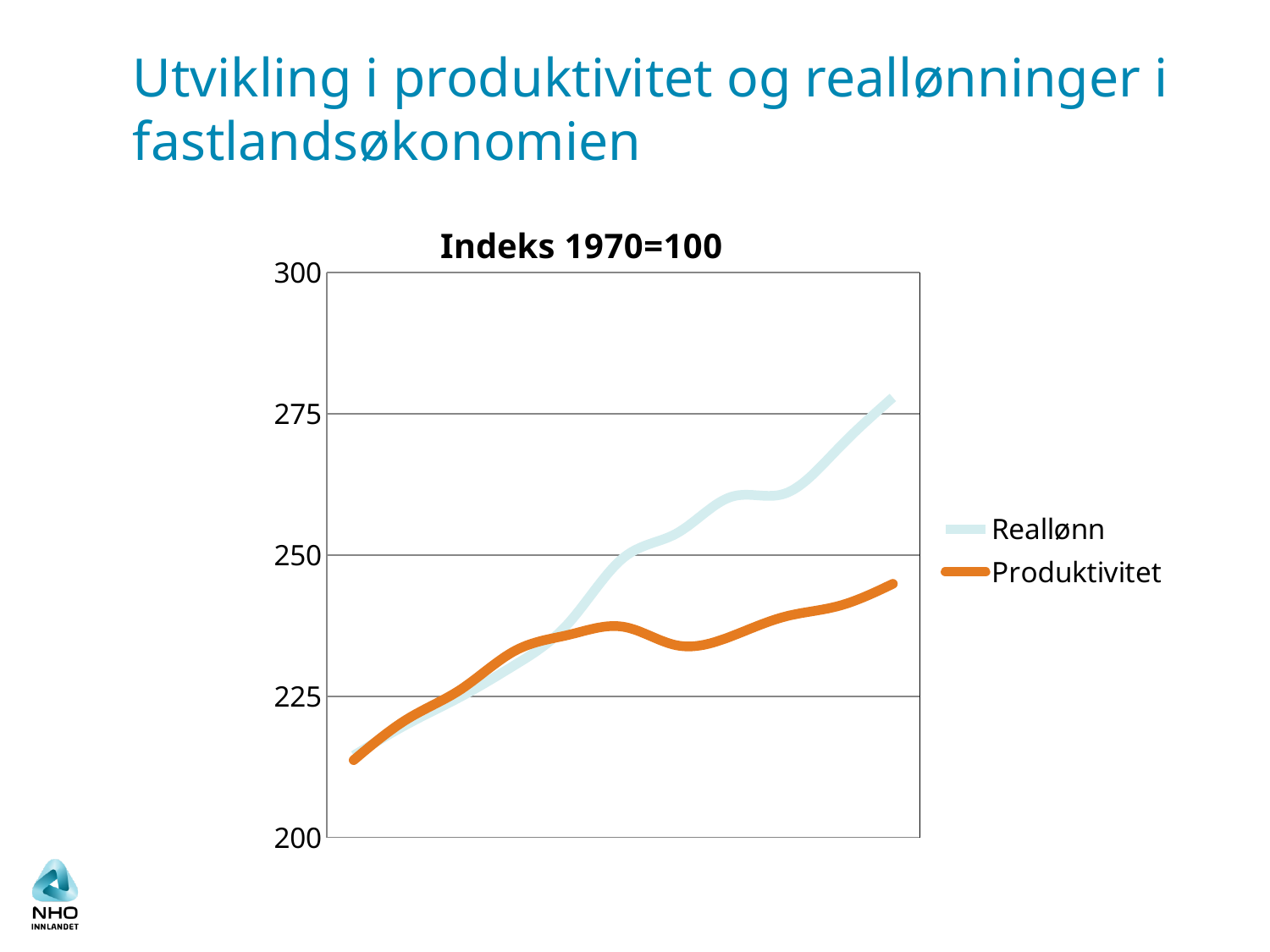
Which series is drawn in orange? Produktivitet What kind of chart is shown on the slide? line chart What is the title of the chart? Indeks 1970=100 Is the starting value of the Produktivitet series greater or less than 225? less Is the final value of the Reallønn series greater or less than 275? greater Which series ends at a higher value at the right end of the chart, Reallønn or Produktivitet? Reallønn Is the final value of the Produktivitet series greater or less than 250? less Does the Produktivitet series generally rise or fall from left to right? rise Does the Reallønn series generally rise or fall from left to right? rise How many series does the legend list? 2